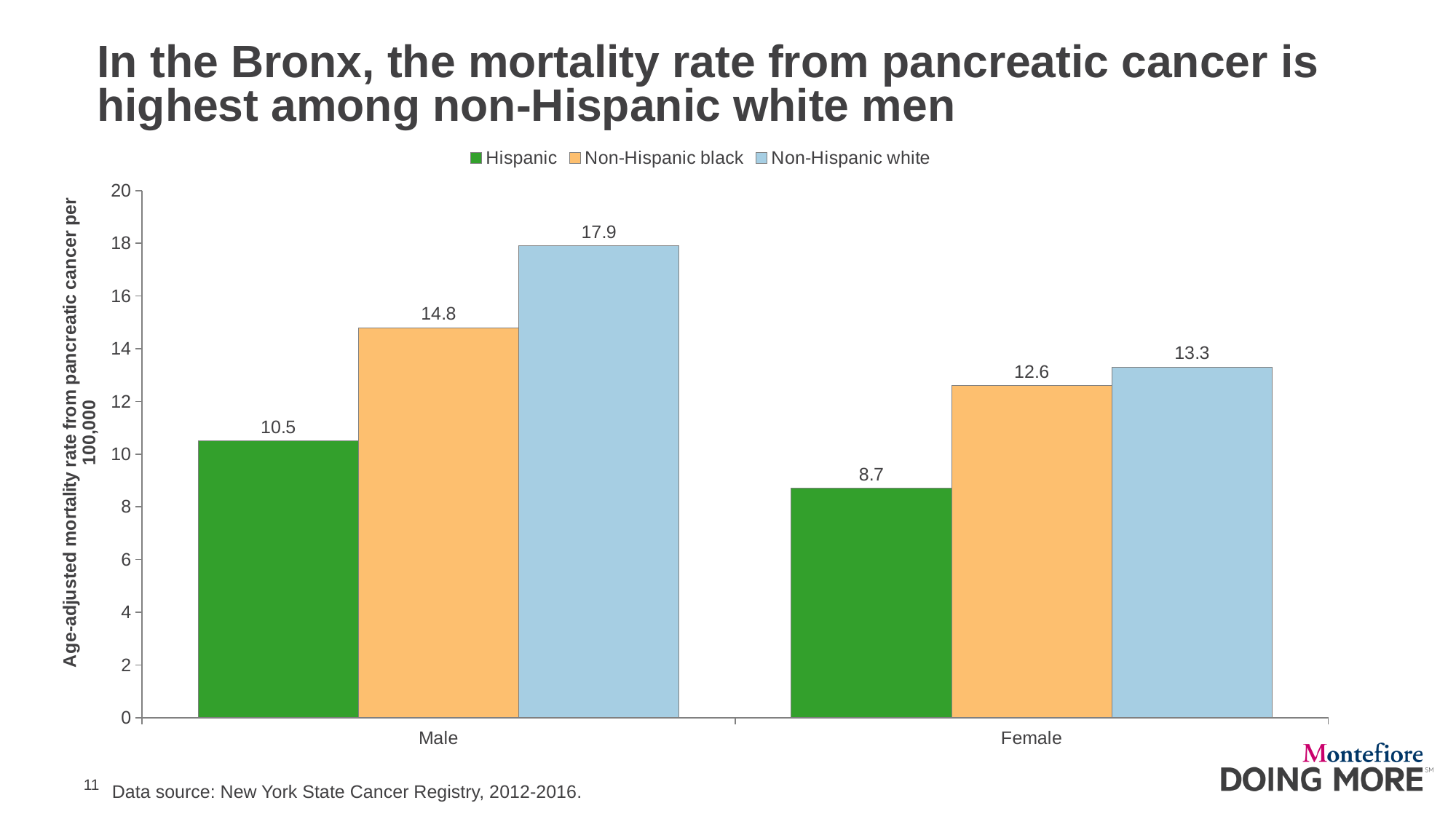
What is the difference between the mortality rates of non-Hispanic white males and Hispanic males? 7.4 How many series does the legend list? 3 What is the difference between the mortality rates of non-Hispanic black females and Hispanic females? 3.9 What is the mortality rate for non-Hispanic white females? 13.3 Which group has the highest mortality rate on the chart? Non-Hispanic white males Which group has the lowest mortality rate on the chart? Hispanic females What is the mortality rate for non-Hispanic black males? 14.8 Is the mortality rate for non-Hispanic white males greater or less than 16? greater What is the age-adjusted mortality rate from pancreatic cancer for Hispanic males? 10.5 What kind of chart is shown on the slide? Bar chart Which colour represents the Hispanic series in the chart? Green Which is larger, the mortality rate for non-Hispanic black males or for non-Hispanic white females? Non-Hispanic black males